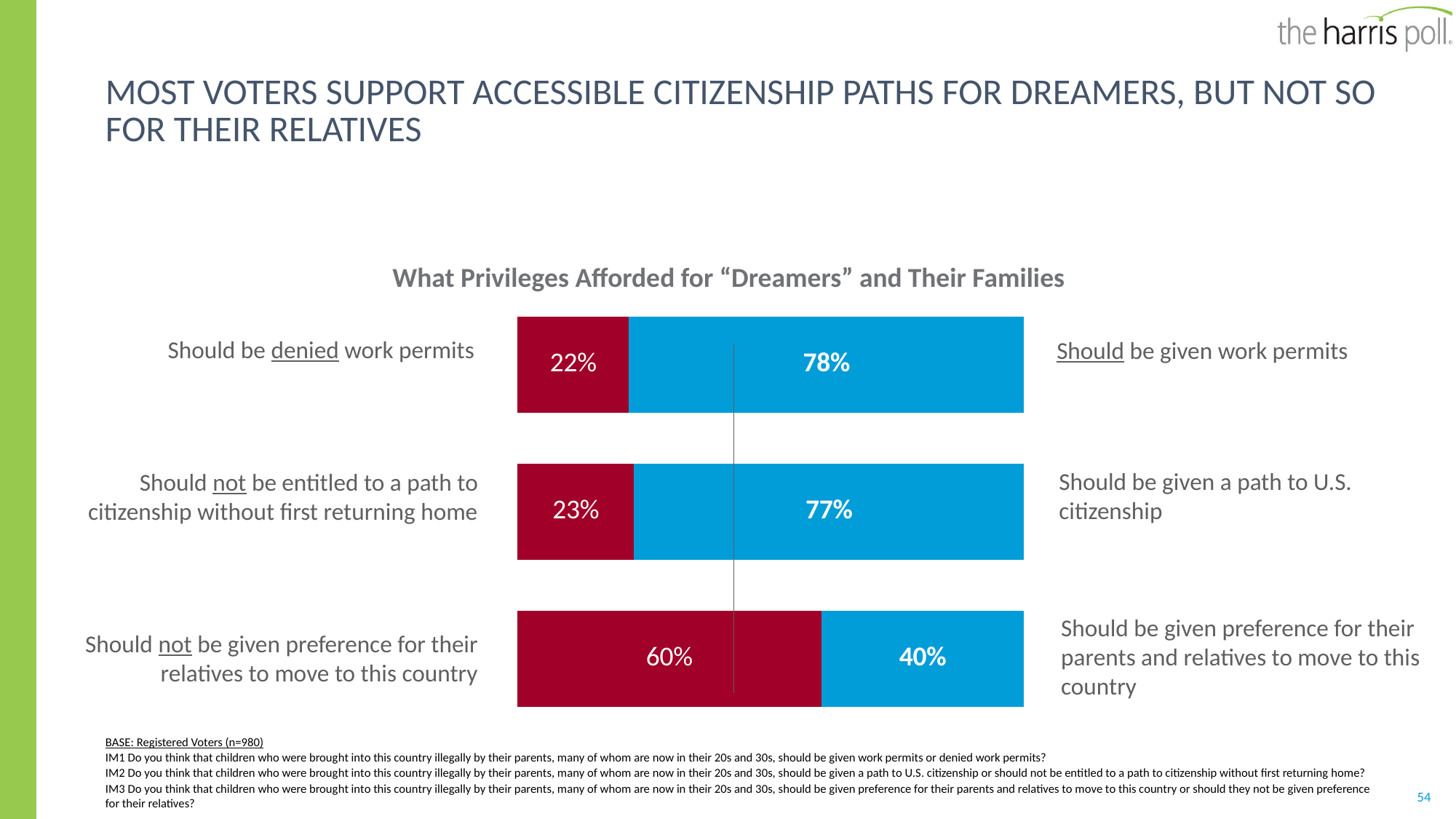
How many items (bars) are shown in the chart? 3 What percentage of voters say Dreamers should not be given preference for their relatives to move to this country? 60% What percentage of voters say Dreamers should be given a path to U.S. citizenship? 77% Which is larger: the share saying Dreamers should be given a path to U.S. citizenship or the share saying they should not be entitled to a path to citizenship without first returning home? Should be given a path to U.S. citizenship Which item has the lowest share of voters on the red (opposing) side? Should be denied work permits What is the title of the chart? What Privileges Afforded for "Dreamers" and Their Families What type of chart is shown on the slide? Stacked bar chart What percentage of voters say Dreamers should be denied work permits? 22% What percentage of voters say Dreamers should be given work permits? 78% Which of the three items has the highest share of voters on the red (opposing) side? Should not be given preference for their relatives to move to this country What is the difference between the share saying Dreamers should be given work permits and the share saying they should be given preference for their relatives to move to this country? 38 percentage points What percentage of voters say Dreamers should be given preference for their parents and relatives to move to this country? 40%